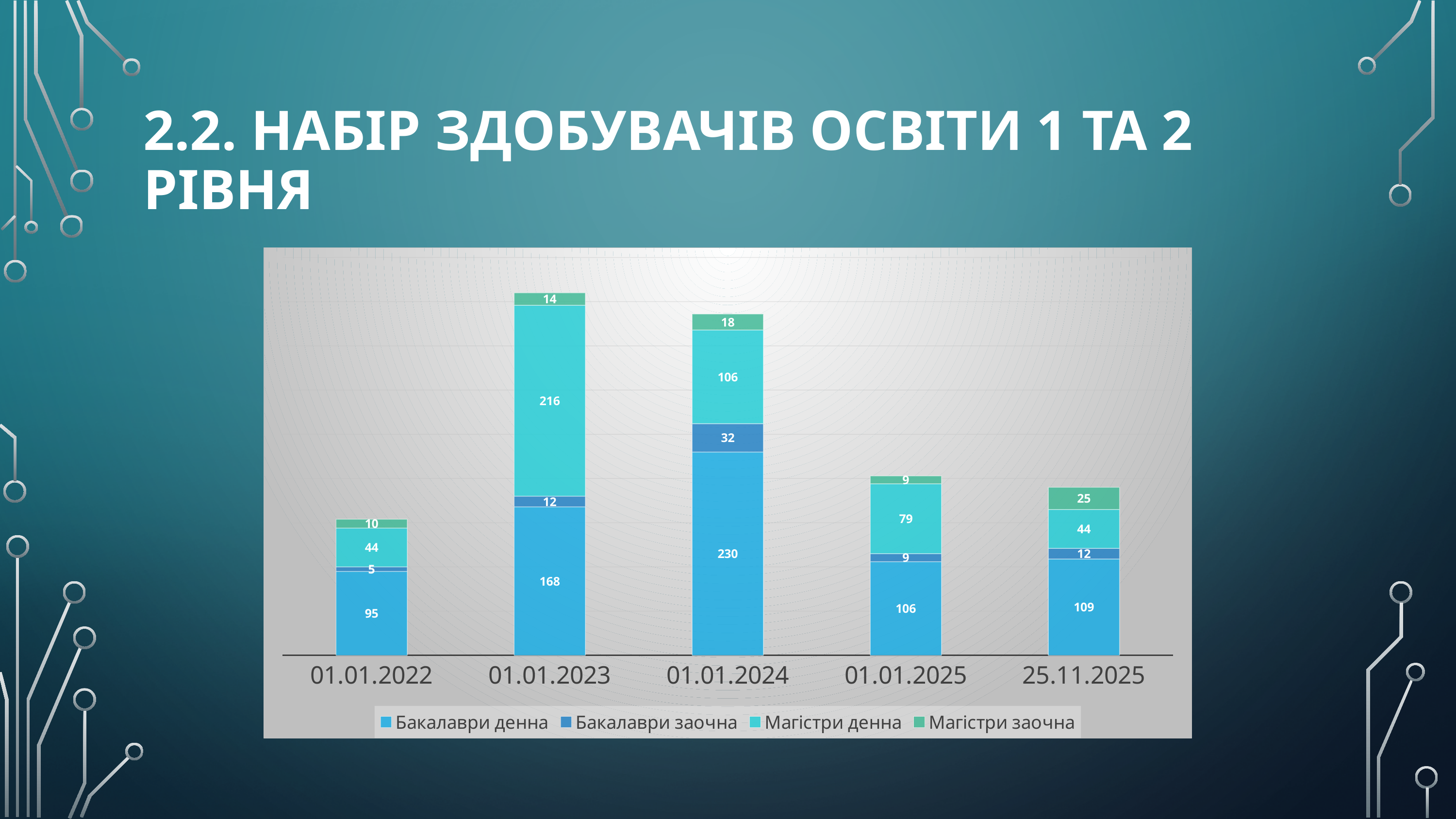
What is the total of the stacked bar for 01.01.2023? 410 What is the value for Бакалаври заочна on 01.01.2022? 5 What type of chart is shown on the slide? Stacked bar chart What is the value for Бакалаври денна on 01.01.2024? 230 How many dates are shown along the x axis? 5 What is the value for Магістри заочна on 25.11.2025? 25 How many series does the legend list? 4 On which date is the Бакалаври денна value highest? 01.01.2024 What is the difference between the Магістри денна values on 01.01.2024 and 01.01.2025? 27 Which is larger: Бакалаври денна on 01.01.2025 or on 25.11.2025? 25.11.2025 What is the value for Магістри денна on 01.01.2023? 216 On which date is the total stacked bar the lowest? 01.01.2022